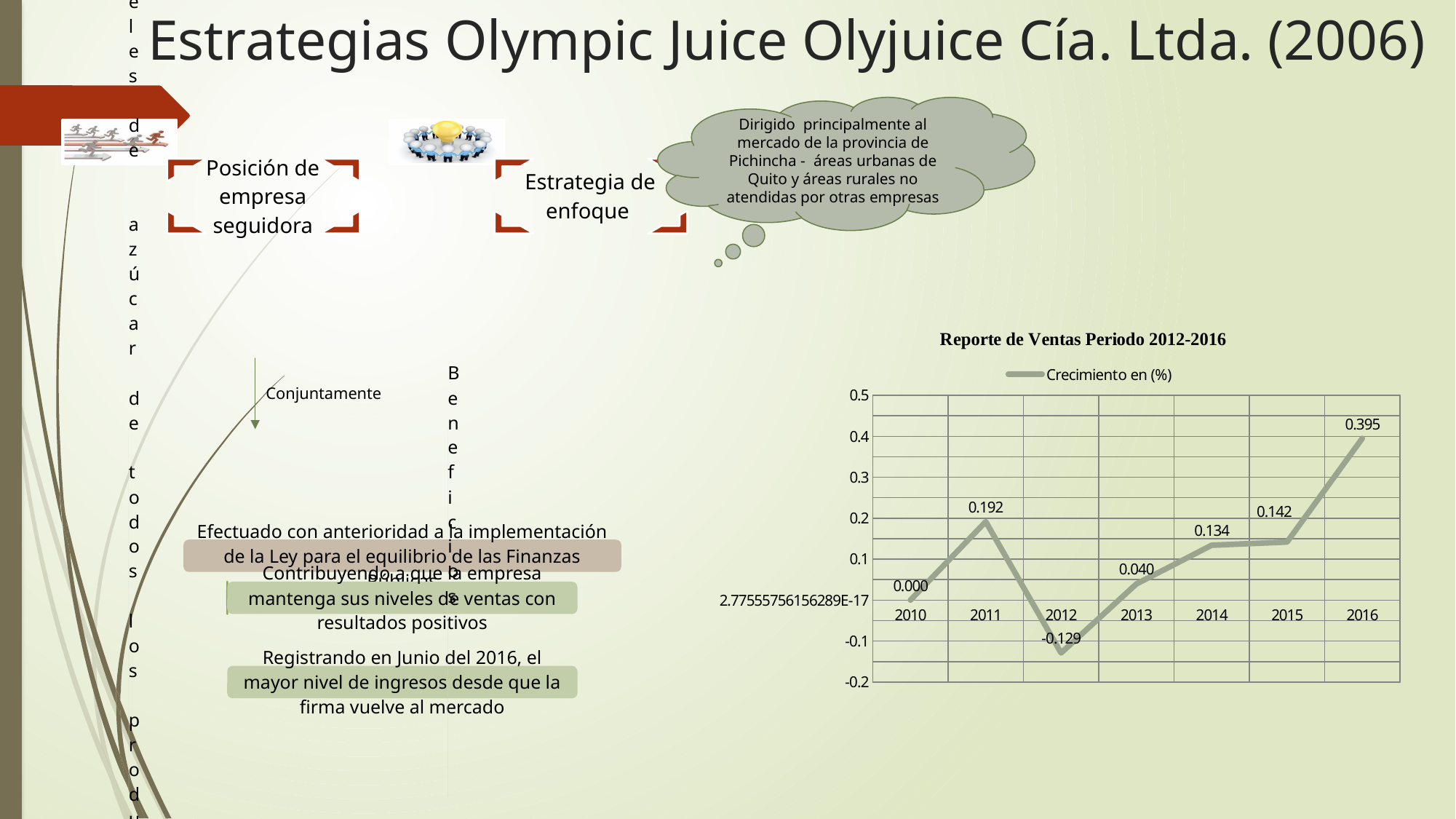
What is the value of Crecimiento en (%) for 2012? -0.129 How many series does the legend list? 1 What type of chart is shown on the slide? Line chart What is the difference between the values for 2016 and 2015? 0.253 Which year has the lowest value of Crecimiento en (%)? 2012 What is the value of Crecimiento en (%) for 2011? 0.192 How many years are plotted on the x axis of the chart? 7 Which year has a larger value, 2013 or 2014? 2014 What series does the chart legend list? Crecimiento en (%) What is the value of Crecimiento en (%) for 2016? 0.395 What is the title of the chart on the slide? Reporte de Ventas Periodo 2012-2016 Which year has the highest value of Crecimiento en (%)? 2016